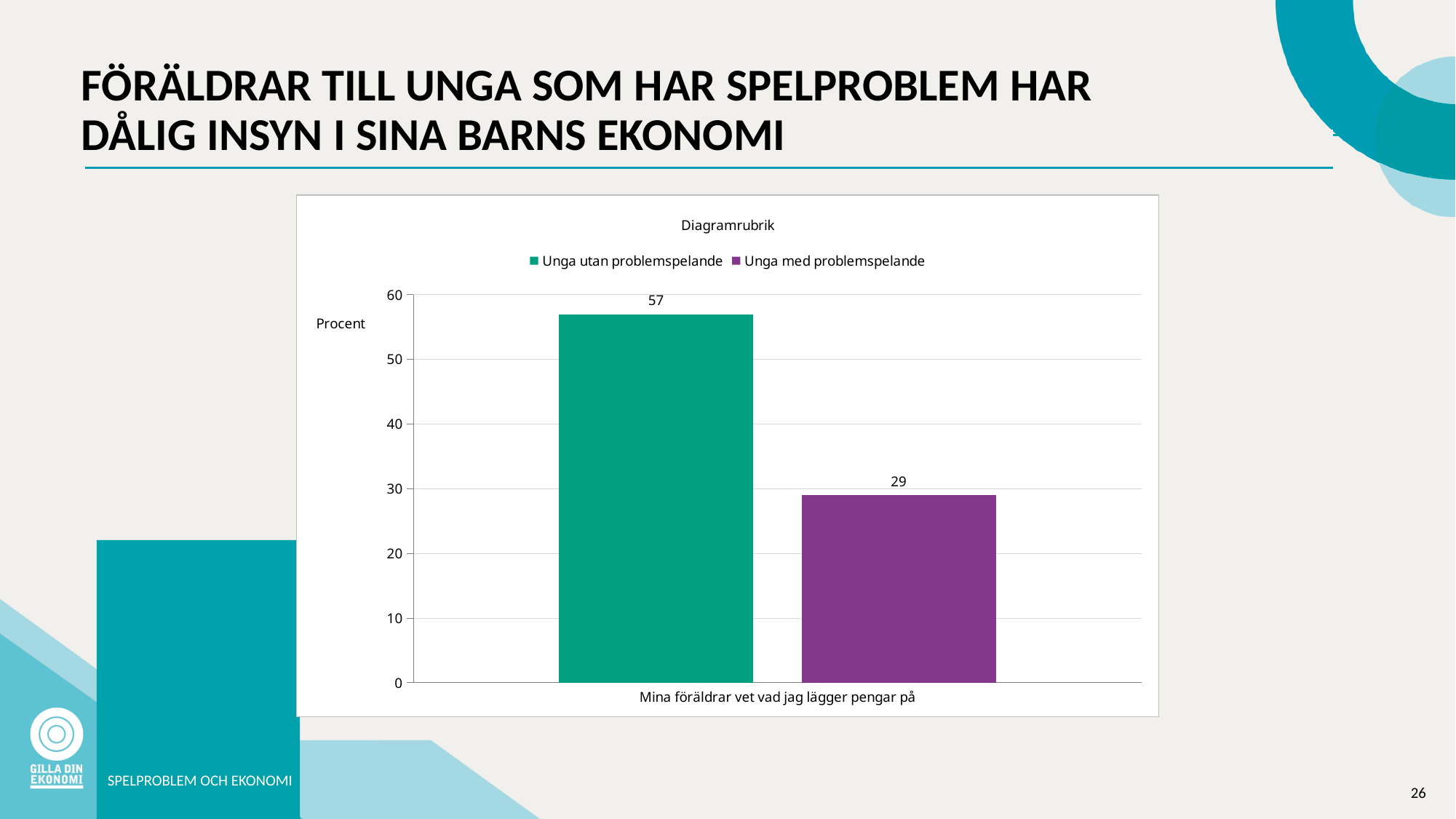
What is the label on the vertical axis? Procent How many series does the legend list? 2 Which series has the higher value? Unga utan problemspelande Is the value for "Unga utan problemspelande" greater or less than 50? greater What is the value for "Unga utan problemspelande"? 57 Which series has the lower value? Unga med problemspelande Is the value for "Unga med problemspelande" greater or less than 30? less What kind of chart is shown on the slide? Bar chart What is the category label on the x axis? Mina föräldrar vet vad jag lägger pengar på What is the title shown above the chart? Diagramrubrik What is the difference between the values for "Unga utan problemspelande" and "Unga med problemspelande"? 28 What is the value for "Unga med problemspelande"? 29